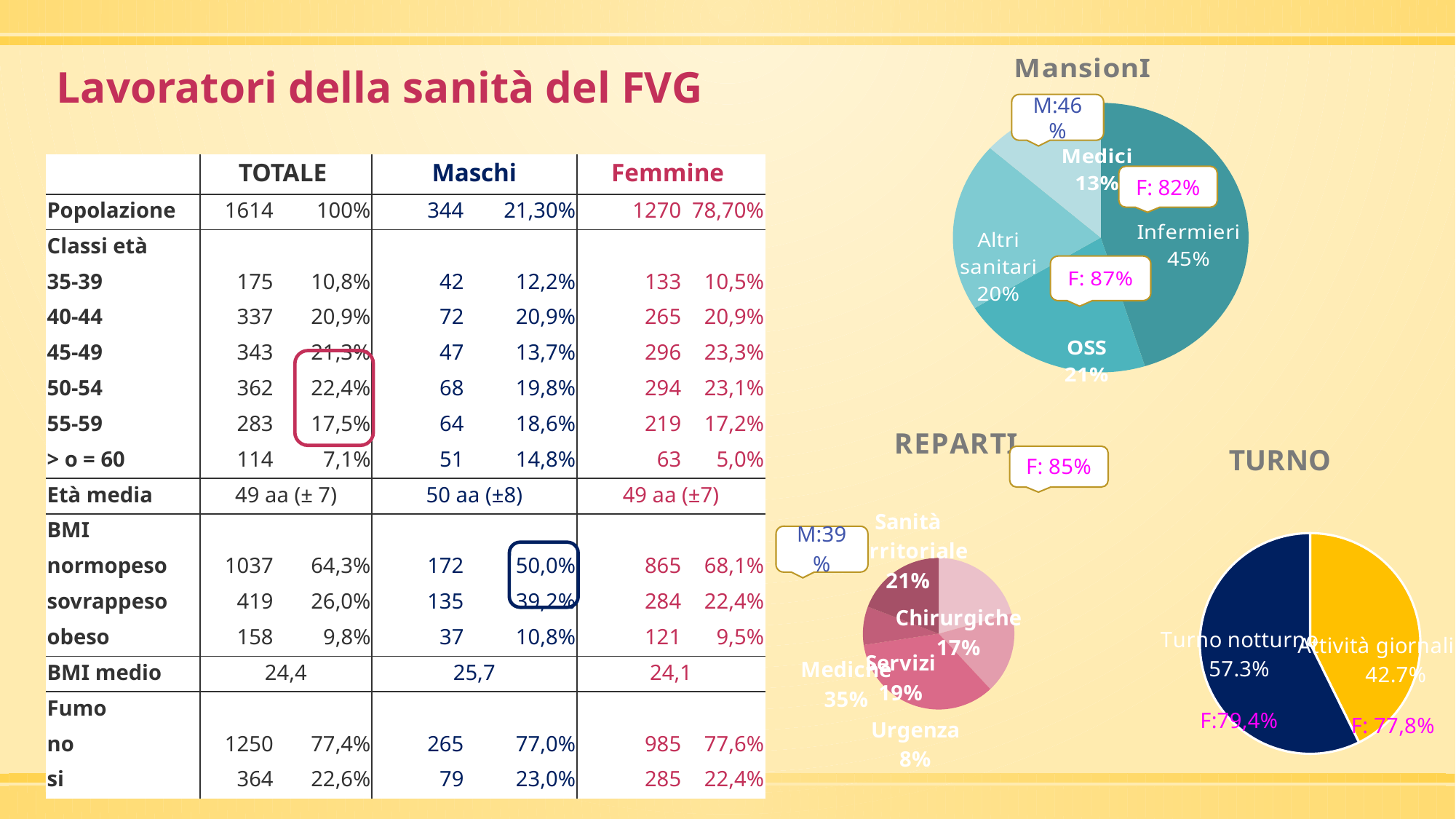
What kind of chart is the TURNO chart? Pie chart In the REPARTI chart, which category has the smallest slice? Urgenza In the MansionI chart, what share of the pie is Infermieri? 45% In the TURNO chart, what is the value for Turno notturno? 57.3% In the TURNO chart, which is larger, Turno notturno or Attività giornaliera? Turno notturno In the REPARTI chart, which is larger, Servizi or Chirurgiche? Servizi In the MansionI chart, which category has the smallest slice? Medici In the MansionI chart, what is the value for Medici? 13% In the REPARTI chart, what is the value for Mediche? 35% In the REPARTI chart, what is the difference between Sanità territoriale and Chirurgiche? 4% In the MansionI chart, how many categories are shown? 4 In the MansionI chart, which category has the largest slice? Infermieri